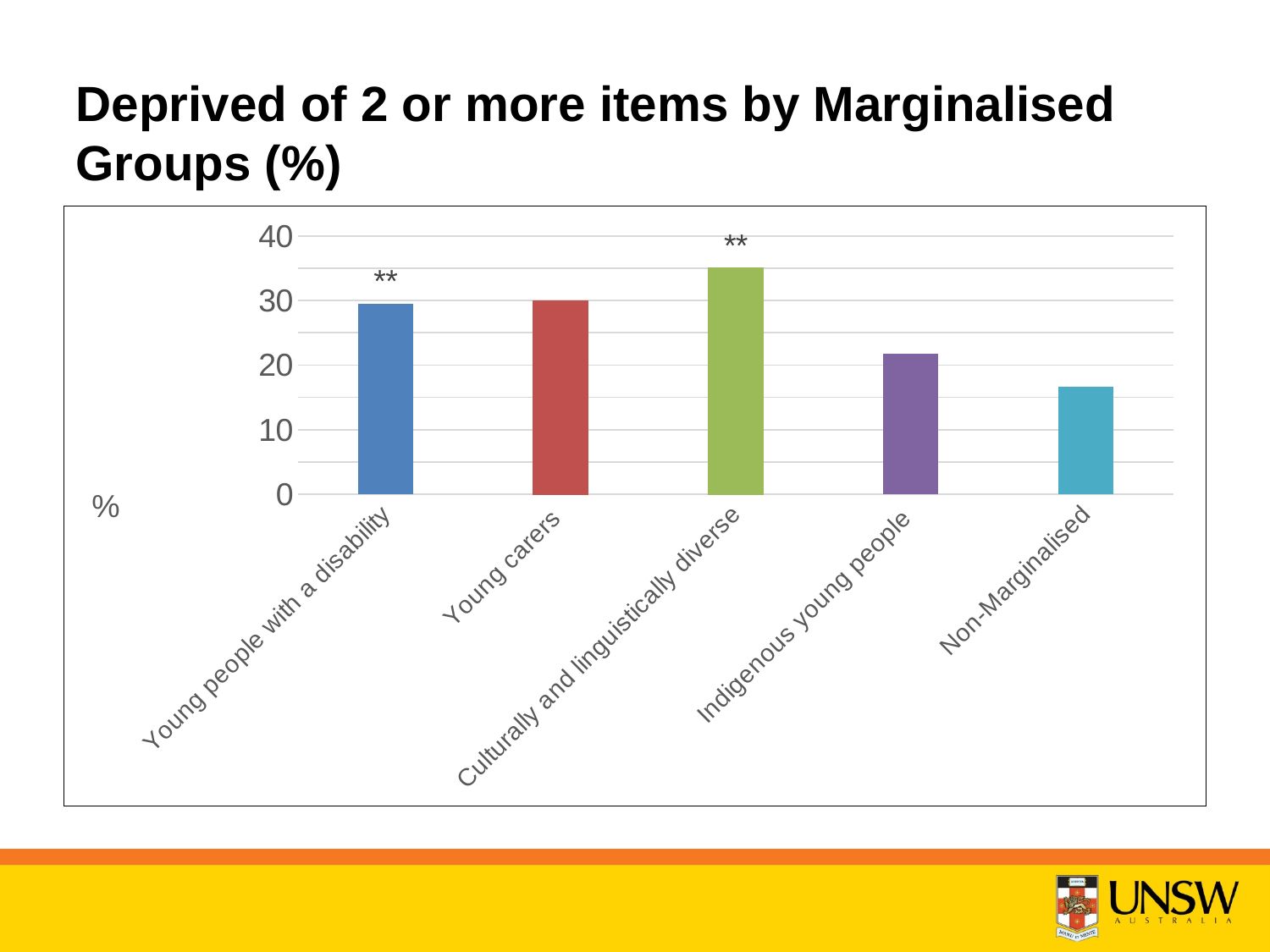
How many marginalised group categories are plotted on the chart? 5 Is the value for Culturally and linguistically diverse greater or less than 30? greater Which group has the highest percentage deprived of 2 or more items? Culturally and linguistically diverse Which two bars are marked with a double asterisk (**)? Young people with a disability and Culturally and linguistically diverse Is the value for Indigenous young people greater or less than 30? less Which group has the lowest percentage deprived of 2 or more items? Non-Marginalised What is the title of the slide's chart? Deprived of 2 or more items by Marginalised Groups (%) Which is larger: the value for Culturally and linguistically diverse or the value for Indigenous young people? Culturally and linguistically diverse Is the value for Non-Marginalised greater or less than 20? less What kind of chart is shown on the slide? bar chart Which is larger: the value for Young carers or the value for Non-Marginalised? Young carers